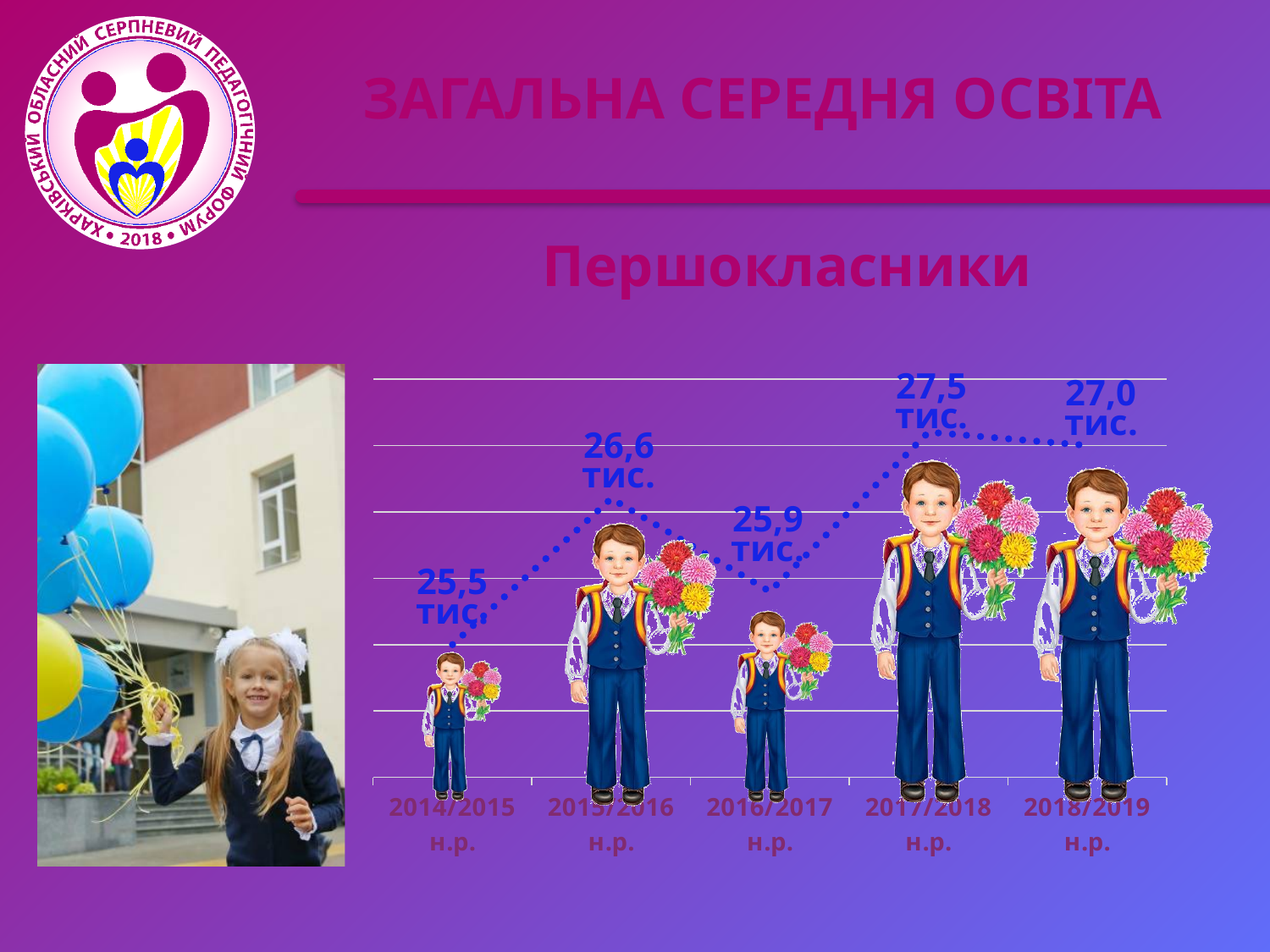
What is the value for 2018/2019 н.р.? 27,0 тис. Which is larger, the value for 2015/2016 н.р. or 2016/2017 н.р.? 2015/2016 н.р. Does the value rise or fall from 2017/2018 н.р. to 2018/2019 н.р.? fall What is the difference between the values for 2015/2016 н.р. and 2016/2017 н.р.? 0,7 тис. Which school year has the lowest value? 2014/2015 н.р. What is the difference between the values for 2017/2018 н.р. and 2014/2015 н.р.? 2,0 тис. Which school year has the highest value? 2017/2018 н.р. What is the value for 2014/2015 н.р.? 25,5 тис. Which is larger, the value for 2017/2018 н.р. or 2018/2019 н.р.? 2017/2018 н.р. What is the title of the chart? Першокласники How many school years are shown on the chart? 5 What is the value for 2016/2017 н.р.? 25,9 тис.